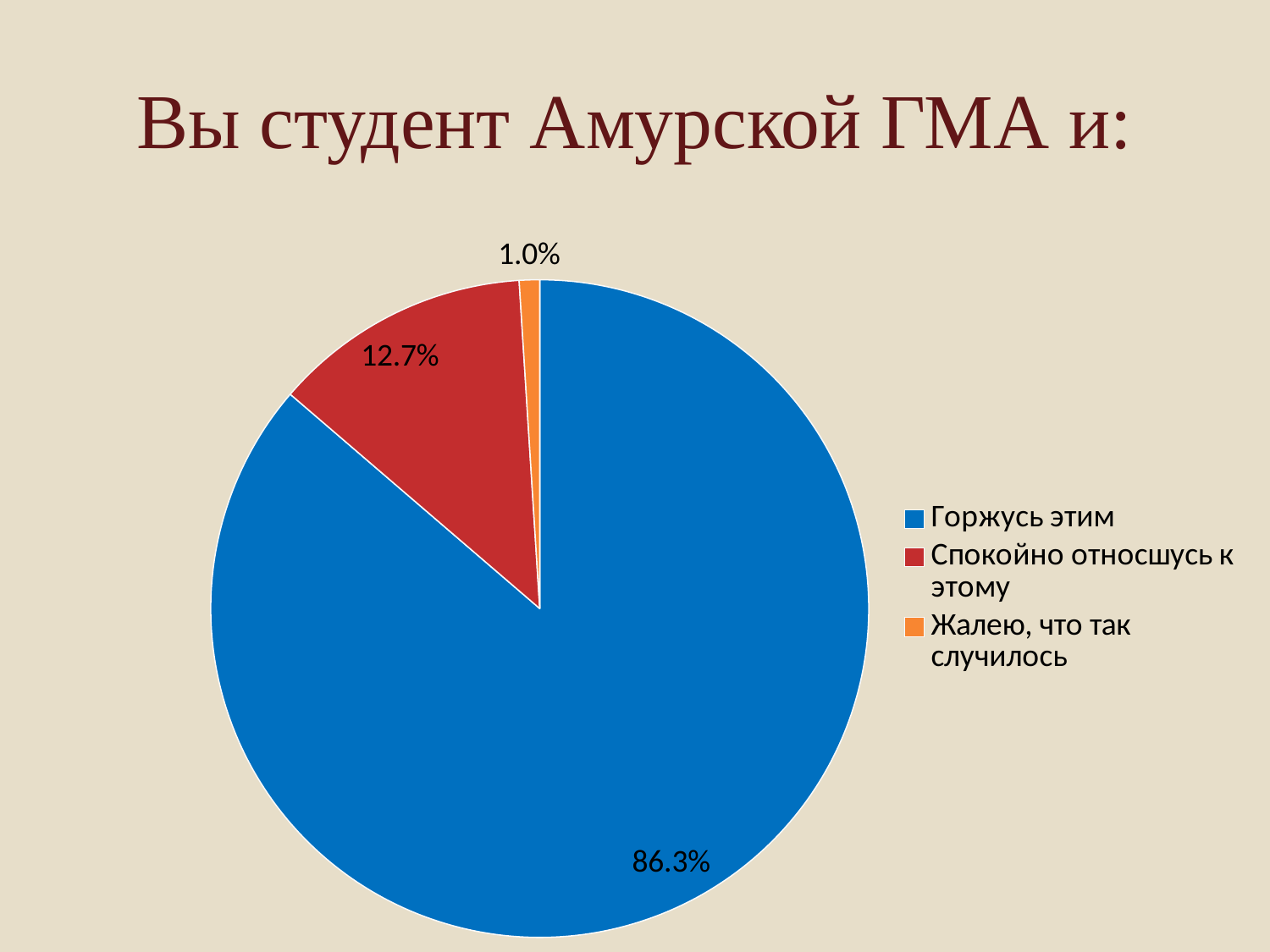
What colour is the slice for "Жалею, что так случилось"? orange Which response has the largest share of the pie? Горжусь этим Which is larger: the share for "Спокойно относшусь к этому" or for "Жалею, что так случилось"? Спокойно относшусь к этому How many slices does the pie chart have? 3 What is the difference in percentage points between "Горжусь этим" and "Спокойно относшусь к этому"? 73.6 What percentage of respondents answered "Горжусь этим"? 86.3% What percentage of respondents answered "Жалею, что так случилось"? 1.0% What type of chart is shown on the slide? pie chart How many entries does the legend list? 3 Which response has the smallest share of the pie? Жалею, что так случилось What percentage of respondents answered "Спокойно относшусь к этому"? 12.7% What is the title of the slide? Вы студент Амурской ГМА и: